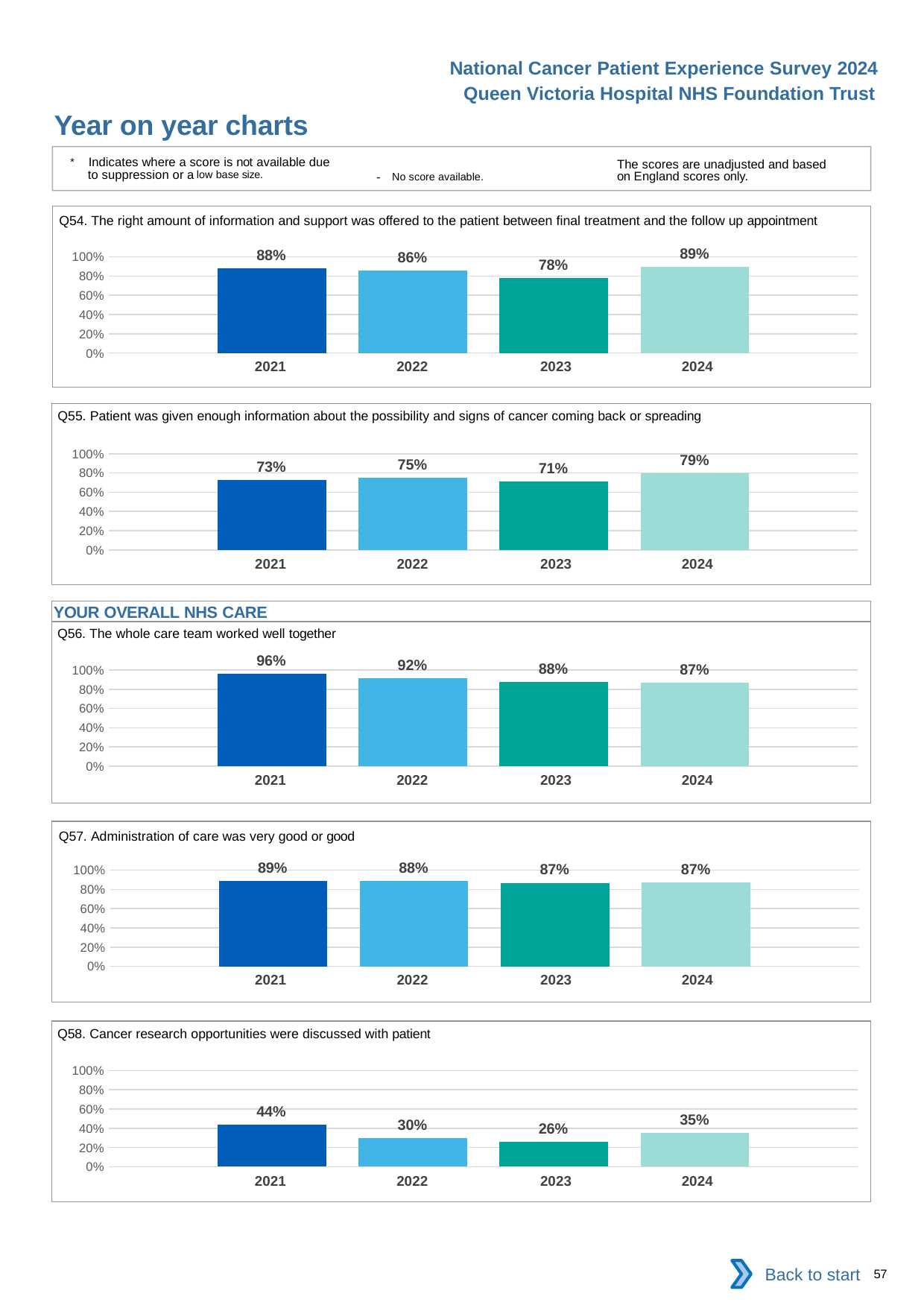
In the Q58 chart, which year has the highest value? 2021 In the Q56 chart, do the values rise or fall from 2021 to 2024? fall In the Q55 chart, which year has the lowest value? 2023 In the Q55 chart, what is the value for 2024? 79% In the Q58 chart, what is the difference between the 2021 and 2023 values? 18% How many years are shown on the x axis of the Q57 chart? 4 In the Q54 chart, what is the value for 2023? 78% In the Q57 chart, what is the value for 2022? 88% In the Q55 chart, what is the difference between the 2024 and 2023 values? 8% In the Q56 chart, what is the value for 2021? 96% In the Q58 chart, is the value for 2021 greater or less than 40%? greater In the Q54 chart, which year has the highest value? 2024